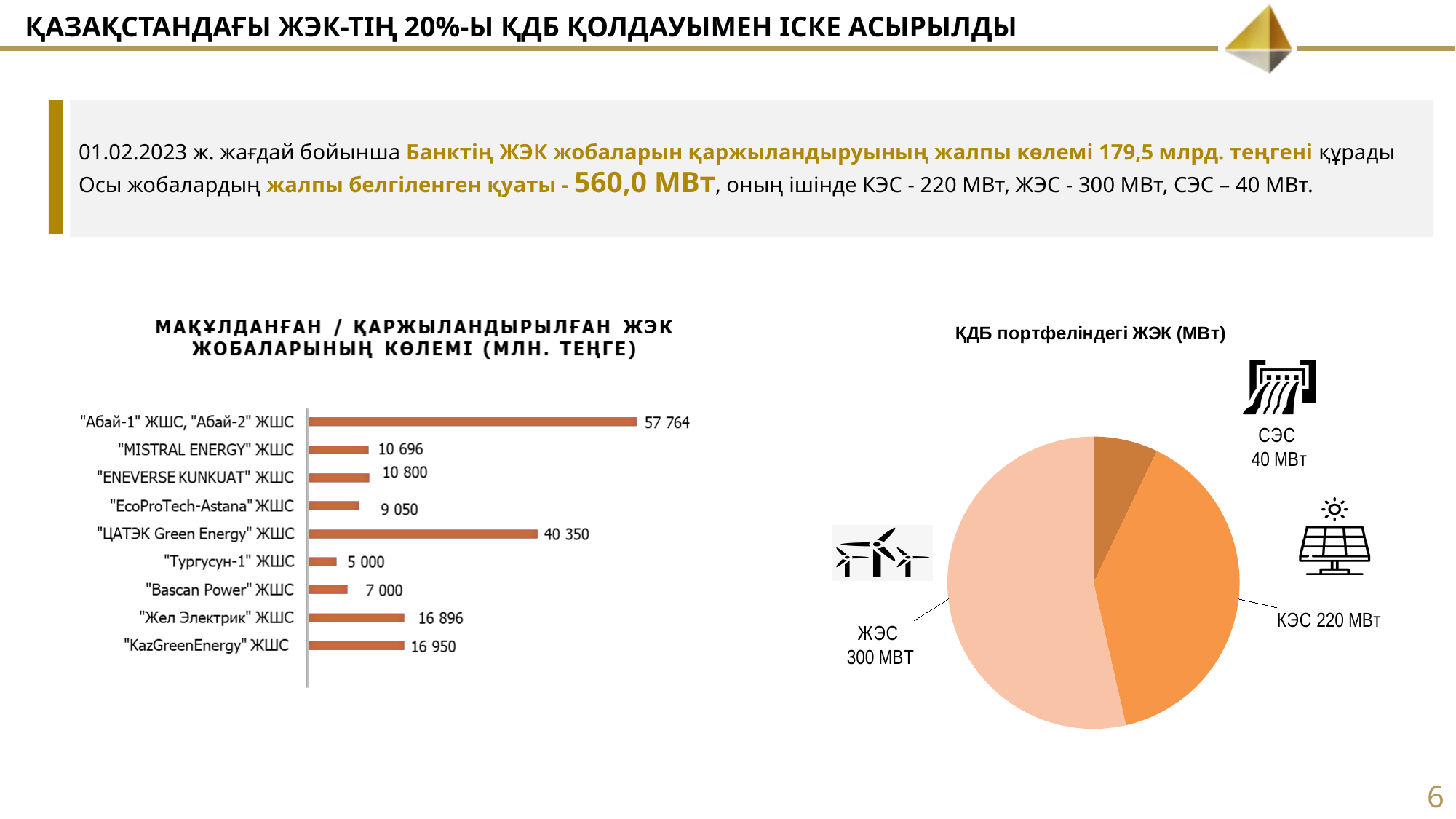
In the bar chart on the left, what is the value for "Тургусун-1" ЖШС? 5 000 In the bar chart on the left, which is larger: the value for "ENEVERSE KUNKUAT" ЖШС or for "MISTRAL ENERGY" ЖШС? "ENEVERSE KUNKUAT" ЖШС How many categories are shown in the bar chart on the left? 9 In the bar chart on the left, what is the value for "ЦАТЭК Green Energy" ЖШС? 40 350 In the bar chart on the left, what is the difference between the values for "Абай-1" ЖШС, "Абай-2" ЖШС and "ЦАТЭК Green Energy" ЖШС? 17 414 In the pie chart "ҚДБ портфеліндегі ЖЭК (МВт)", which slice is the smallest? СЭС In the bar chart on the left, which category has the highest value? "Абай-1" ЖШС, "Абай-2" ЖШС In the pie chart "ҚДБ портфеліндегі ЖЭК (МВт)", what is the value for КЭС? 220 МВт How many slices does the pie chart "ҚДБ портфеліндегі ЖЭК (МВт)" have? 3 In the bar chart on the left, which category has the lowest value? "Тургусун-1" ЖШС What kind of chart is the chart on the left? Bar chart In the pie chart "ҚДБ портфеліндегі ЖЭК (МВт)", what is the difference between the values for ЖЭС and КЭС? 80 МВт